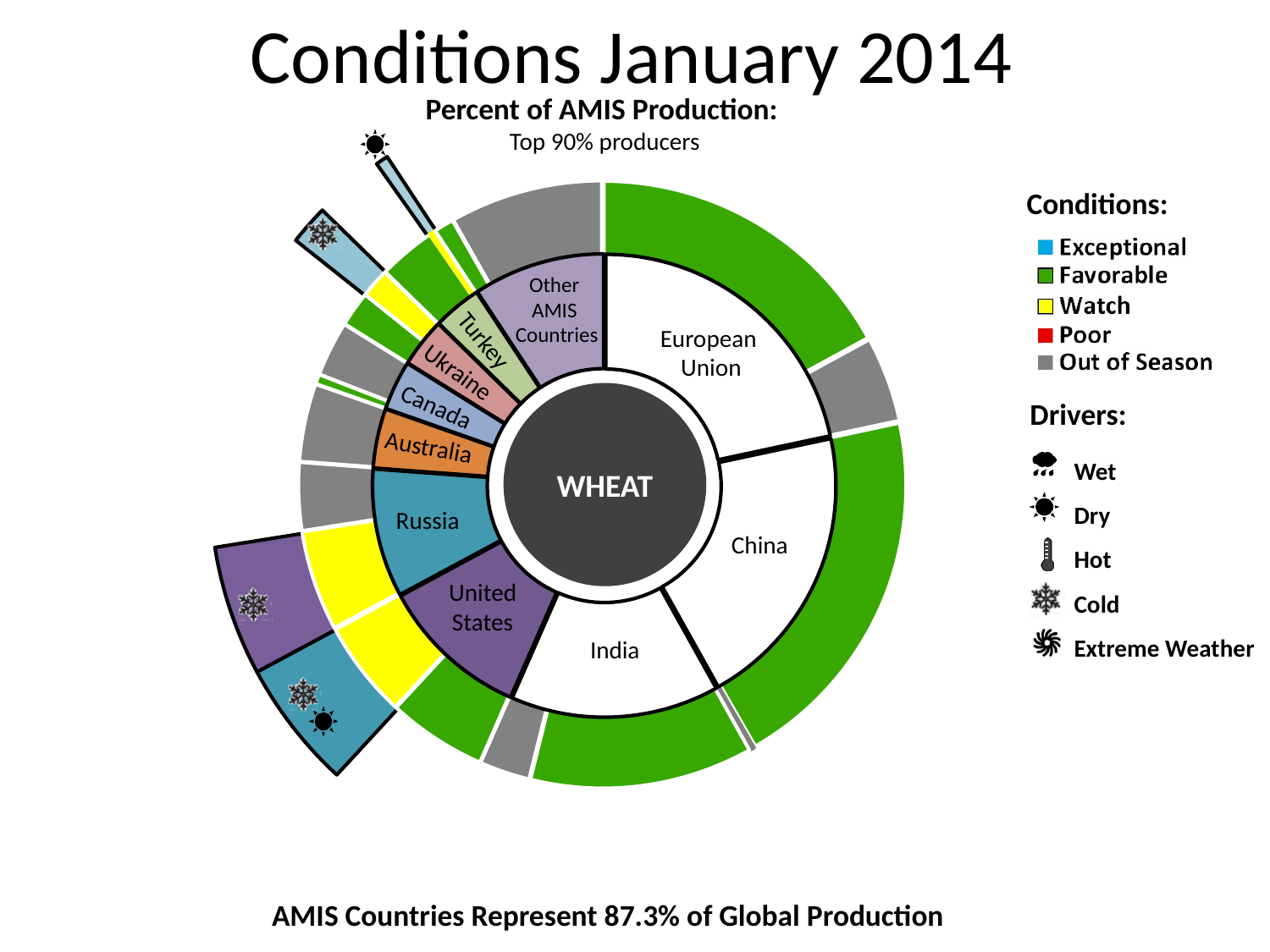
How many condition categories does the Conditions legend list? 5 How many named countries or country groups are labelled in the inner ring of the chart? 10 According to the footer, what percent of global production do AMIS countries represent? 87.3% How many drivers does the Drivers legend list? 5 Which is larger in the inner ring, the China slice or the Australia slice? China Which is larger in the inner ring, the European Union slice or the Turkey slice? European Union What commodity is named in the centre of the chart? WHEAT What colour does the legend use for the Favorable condition? green Which is larger in the inner ring, the Russia slice or the Canada slice? Russia What is the subtitle printed above the chart? Percent of AMIS Production: Top 90% producers What kind of chart is shown on the slide? doughnut chart